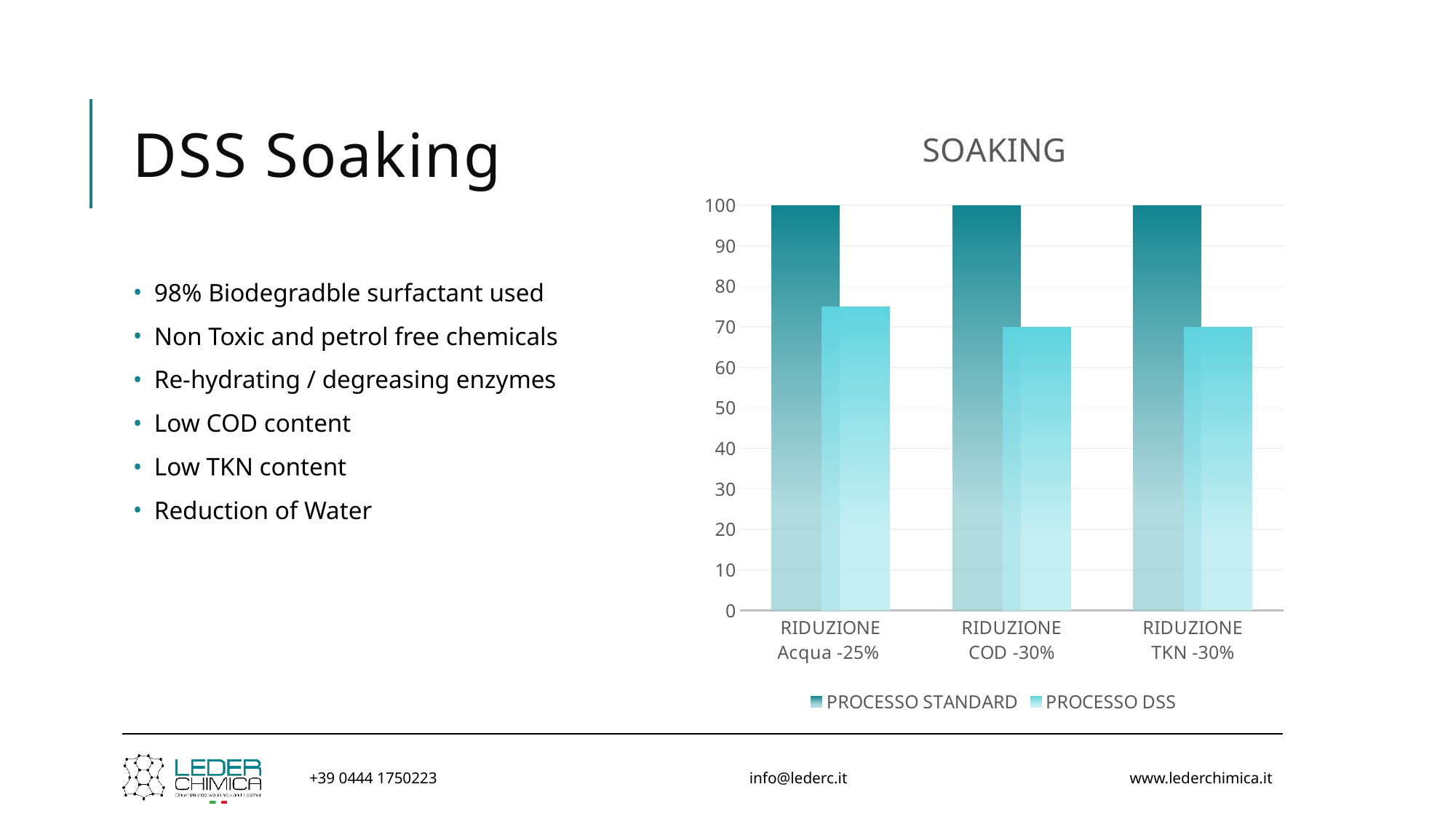
What is the PROCESSO DSS value for RIDUZIONE TKN -30%? 70 Is the PROCESSO DSS value for RIDUZIONE Acqua -25% greater or less than 80? less What is the difference between the PROCESSO STANDARD and PROCESSO DSS values for RIDUZIONE COD -30%? 30 How many categories are shown on the x axis of the chart? 3 What is the title of the chart? SOAKING How many series does the chart legend list? 2 Which category has the highest PROCESSO DSS value? RIDUZIONE Acqua -25% What kind of chart is shown on the slide? bar chart What is the PROCESSO STANDARD value for RIDUZIONE COD -30%? 100 Is the PROCESSO DSS value for RIDUZIONE Acqua -25% greater or less than 70? greater For RIDUZIONE Acqua -25%, which series has the larger value, PROCESSO STANDARD or PROCESSO DSS? PROCESSO STANDARD What is the PROCESSO DSS value for RIDUZIONE COD -30%? 70